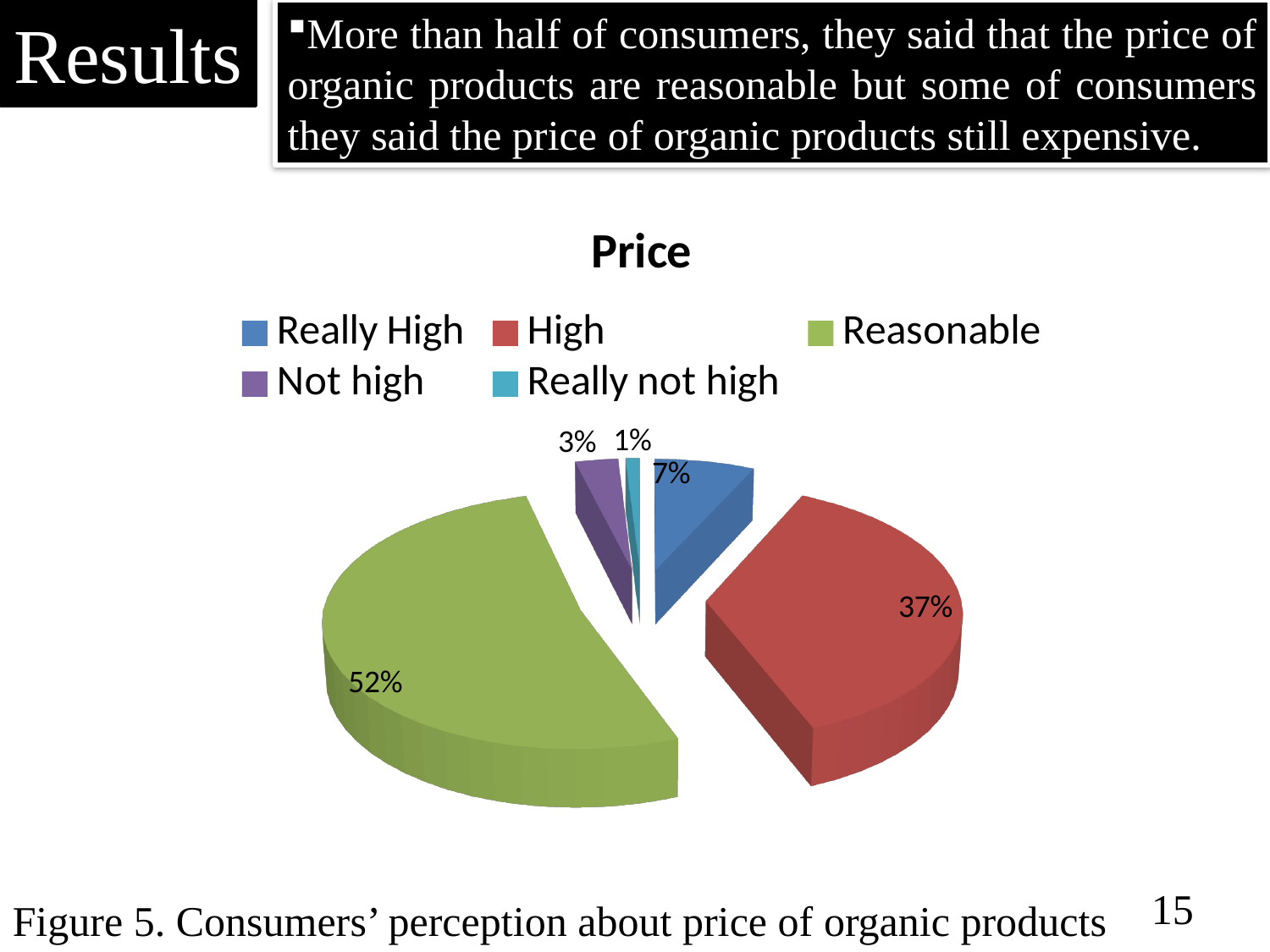
What is the value for Really not high? 1% What is the value for Not high? 3% Which category has the smallest slice? Really not high What is the value for Really High? 7% Which category has the largest slice? Reasonable How many categories does the legend list? 5 Which is larger, Really High or Not high? Really High What type of chart is shown on the slide? Pie chart What share of the pie does the Reasonable slice represent? 52% What is the difference between the Reasonable and High slices? 15% What is the title of the chart? Price What share of the pie does the High slice represent? 37%